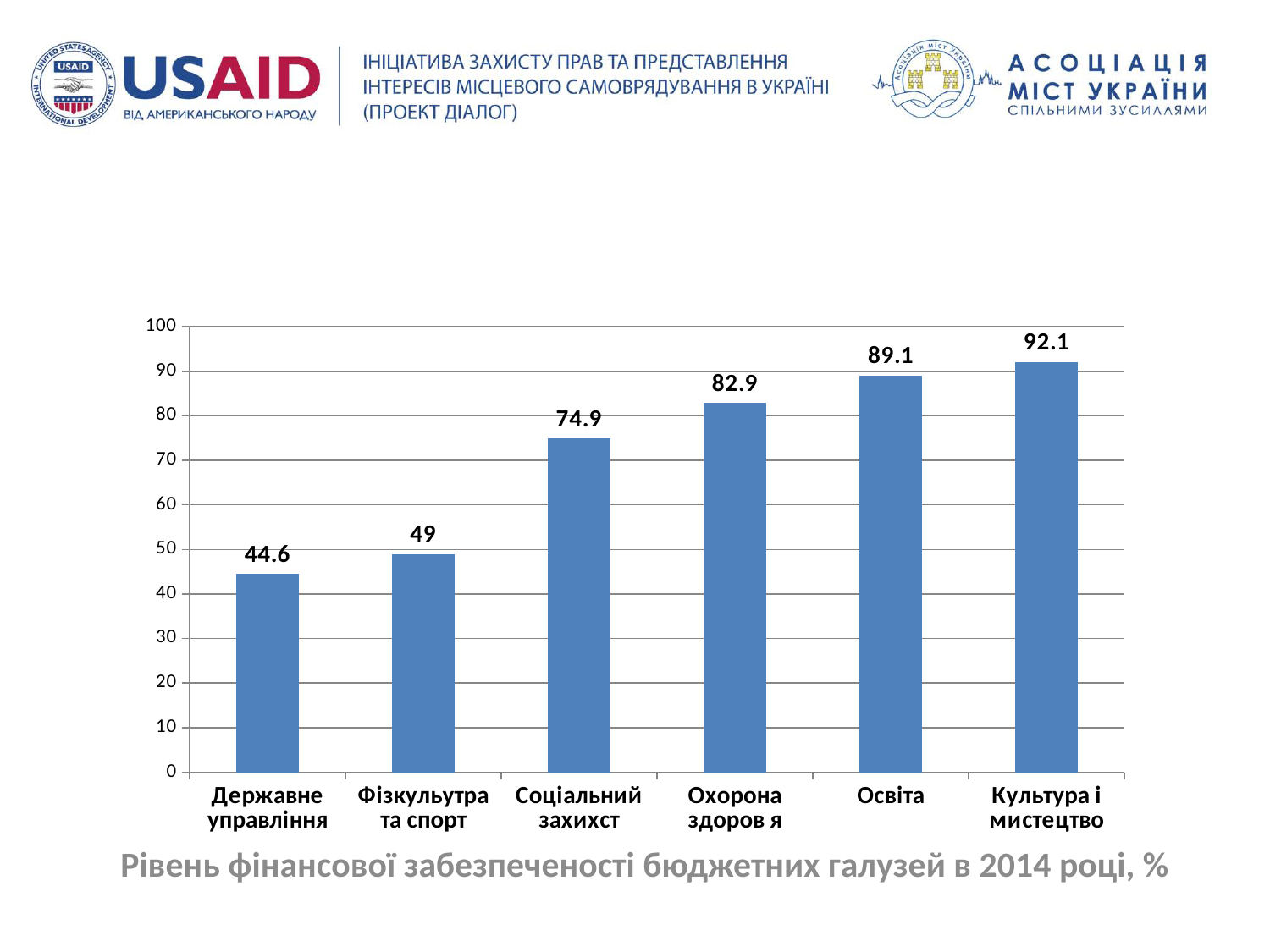
What is the title shown below the chart? Рівень фінансової забезпеченості бюджетних галузей в 2014 році, % What is the value for Освіта? 89.1 Which category has the highest value? Культура і мистецтво What is the difference between the values for Культура і мистецтво and Державне управління? 47.5 Is the value for Соціальний захихст greater or less than 70? greater What is the difference between the values for Соціальний захихст and Фізкульутра та спорт? 25.9 Which category has the lowest value? Державне управління How many categories are shown on the chart? 6 What is the value for Охорона здоров я? 82.9 Which is larger, the value for Освіта or the value for Охорона здоров я? Освіта What kind of chart is shown on the slide? bar chart What is the value for Державне управління? 44.6